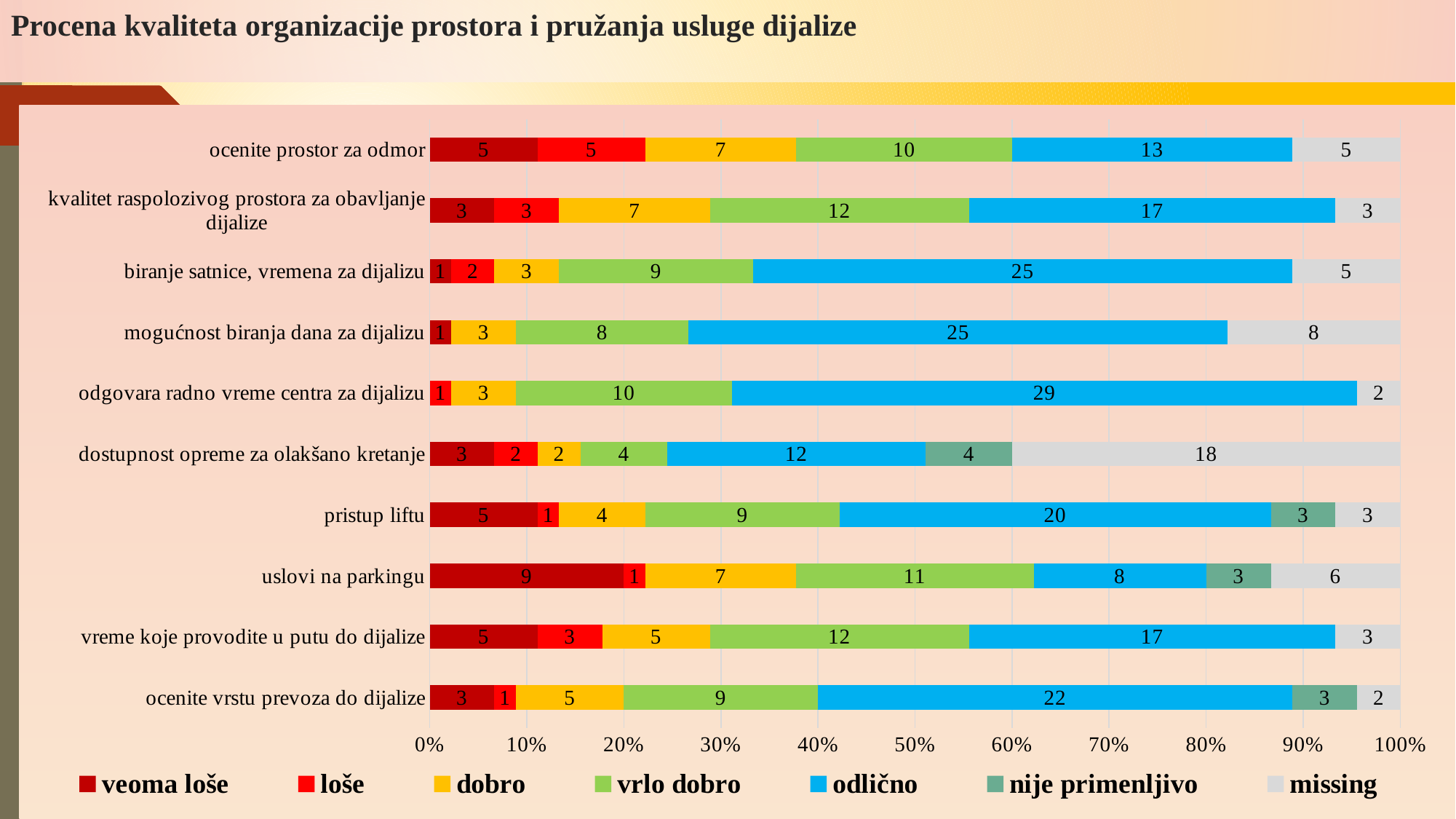
What is the title of the chart? Procena kvaliteta organizacije prostora i pružanja usluge dijalize How many series does the legend list? 7 Which category has the lowest 'odlično' value? uslovi na parkingu What is the difference between the 'odlično' values for 'ocenite vrstu prevoza do dijalize' and 'pristup liftu'? 2 What is the total of all segments in the bar for 'pristup liftu'? 45 What is the value of 'odlično' for 'odgovara radno vreme centra za dijalizu'? 29 Which category has the highest 'odlično' value? odgovara radno vreme centra za dijalizu Which is larger: the 'vrlo dobro' value for 'uslovi na parkingu' or for 'ocenite prostor za odmor'? uslovi na parkingu What is the value of 'missing' for 'dostupnost opreme za olakšano kretanje'? 18 How many categories are plotted on the chart? 10 What kind of chart is shown on the slide? stacked bar chart What is the value of 'veoma loše' for 'uslovi na parkingu'? 9